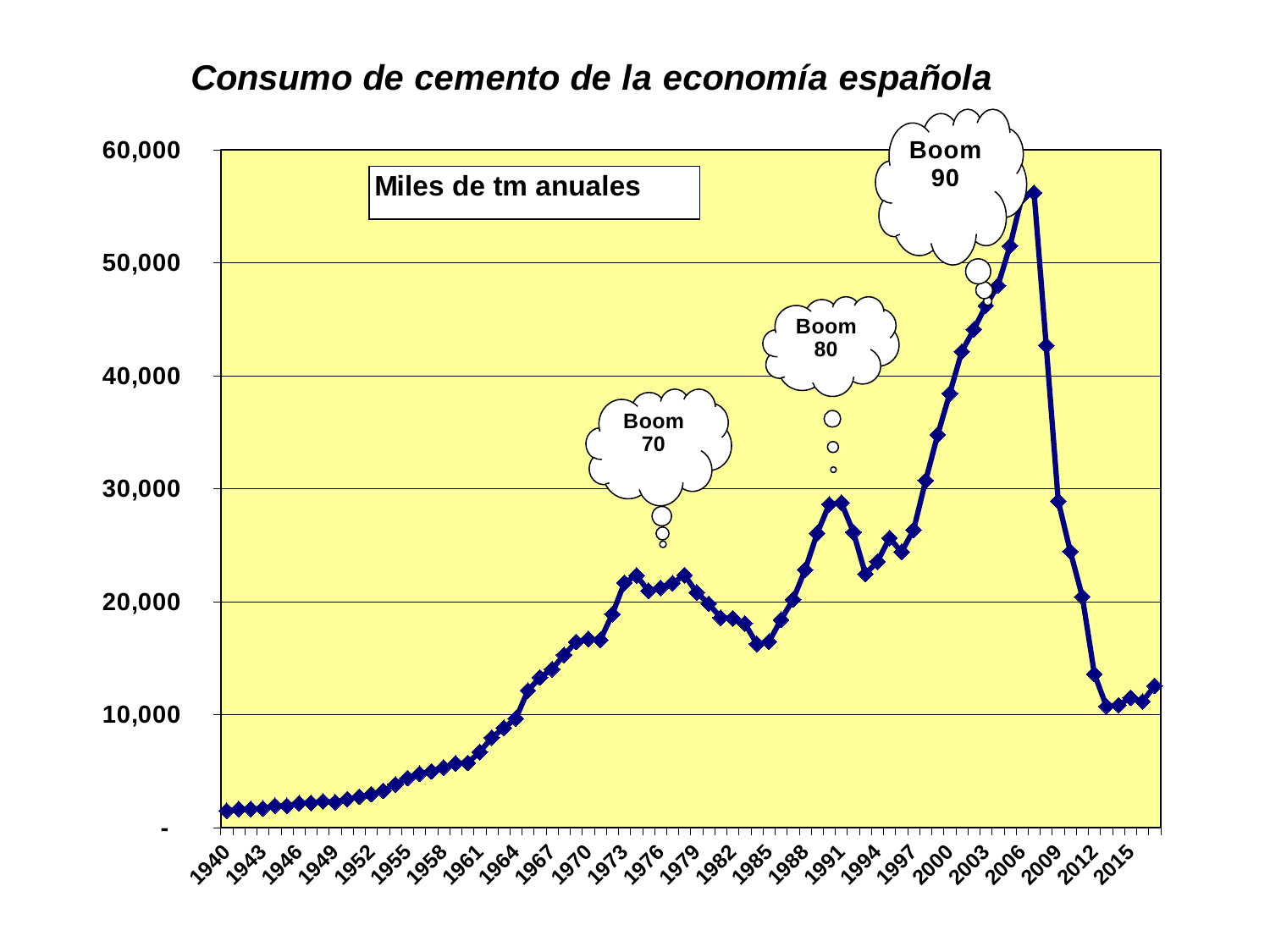
Is the value for 1985 greater or less than 20,000? less Is the value for 1940 greater or less than 10,000? less Is the value for 2012 greater or less than 20,000? less What kind of chart is shown on the slide? line chart What is the title of the chart? Consumo de cemento de la economía española Does the value rise or fall from 1940 to 1973? rise Does the value rise or fall from 2009 to 2012? fall Which year has the larger value, 1991 or 1973? 1991 What unit is stated in the box inside the chart? Miles de tm anuales